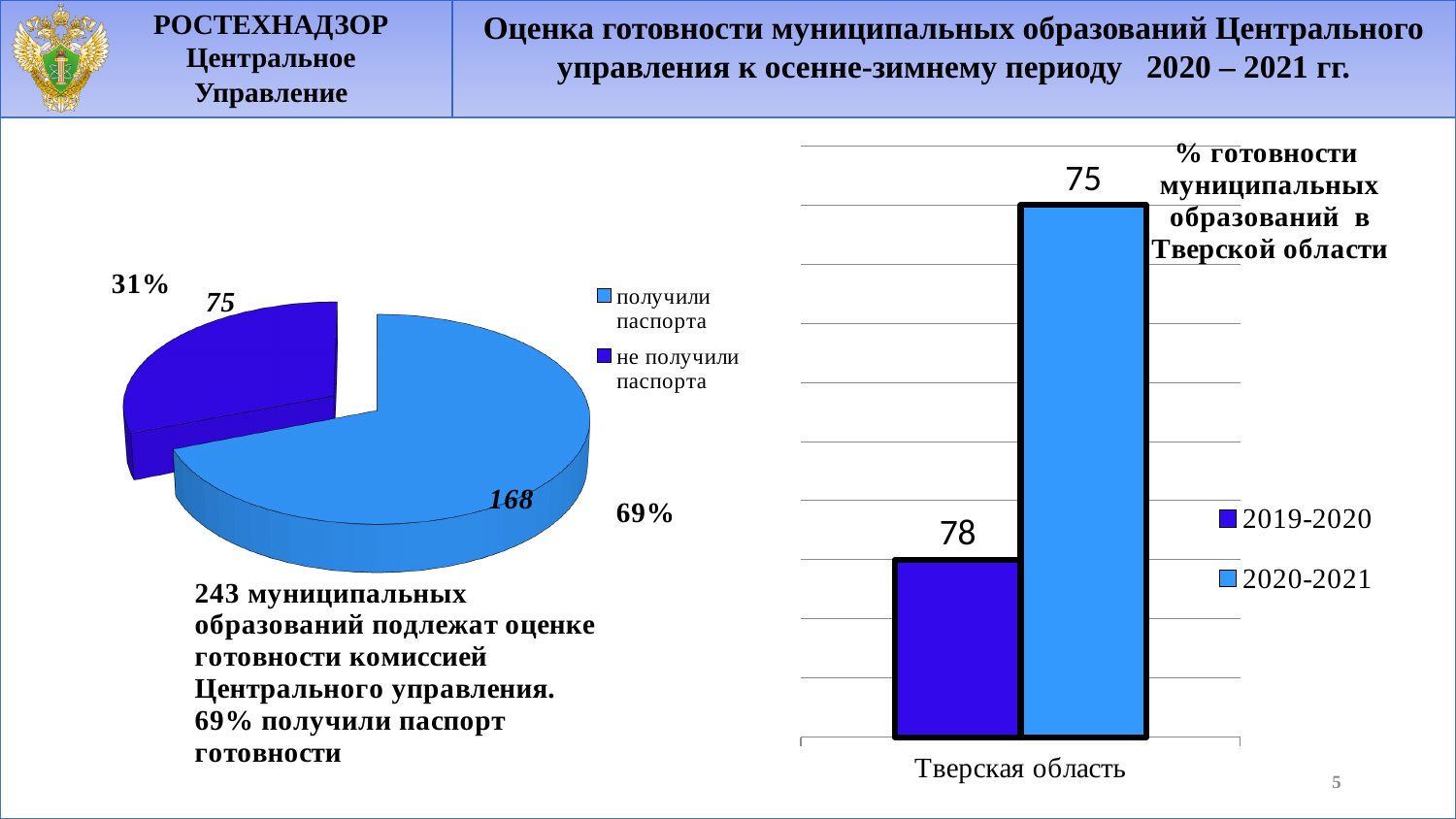
In the pie chart on the left, which slice is the largest? получили паспорта In the pie chart on the left, what percentage share is shown for the "не получили паспорта" slice? 31% In the pie chart on the left, how many entries does the legend list? 2 In the pie chart on the left, what is the value for the slice labelled "не получили паспорта"? 75 In the bar chart "% готовности муниципальных образований в Тверской области", what is the value for the 2020-2021 series? 75 In the bar chart "% готовности муниципальных образований в Тверской области", what is the value for the 2019-2020 series? 78 In the pie chart on the left, what is the value for the slice labelled "получили паспорта"? 168 In the pie chart on the left, what percentage share is shown for the "получили паспорта" slice? 69% What kind of chart is the chart on the left of the slide? Pie chart In the bar chart "% готовности муниципальных образований в Тверской области", what is the difference between the 2019-2020 and 2020-2021 values? 3 In the pie chart on the left, what is the difference between the two slice values, 168 and 75? 93